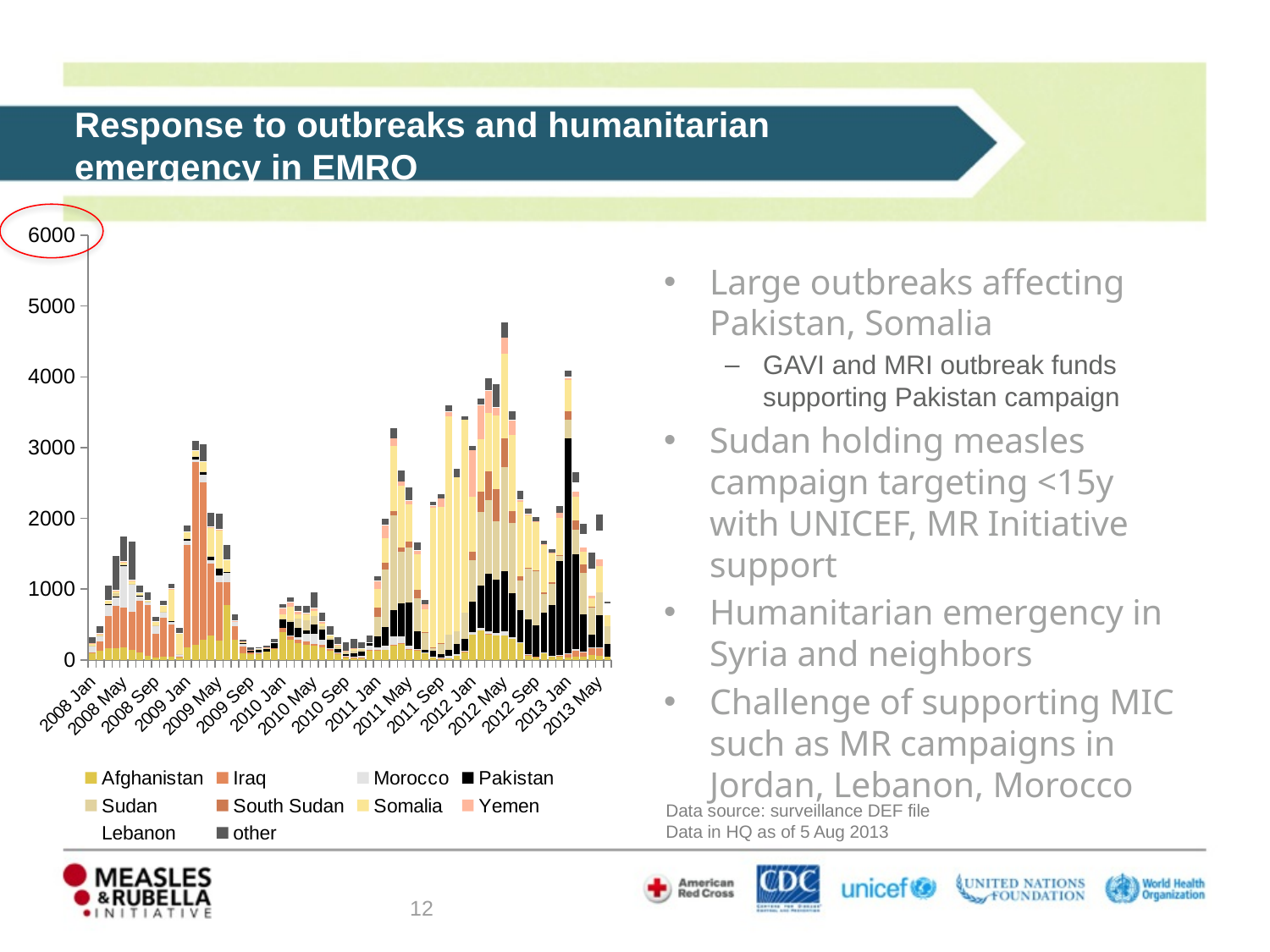
What kind of chart is shown on the slide? Stacked bar chart Is the total value for 2008 Jan greater or less than 1000? less Is the total value for 2010 Jan greater or less than 1000? less How many series does the chart legend list? 10 What is the highest value shown on the chart's vertical axis? 6000 What is the first month label on the chart's x axis? 2008 Jan Is the total value for 2013 Jan greater or less than 2000? greater Which has the larger total, 2010 Jan or 2012 Jan? 2012 Jan Which series in the chart is shown in black? Pakistan Which has the larger total, 2008 Jan or 2009 May? 2009 May